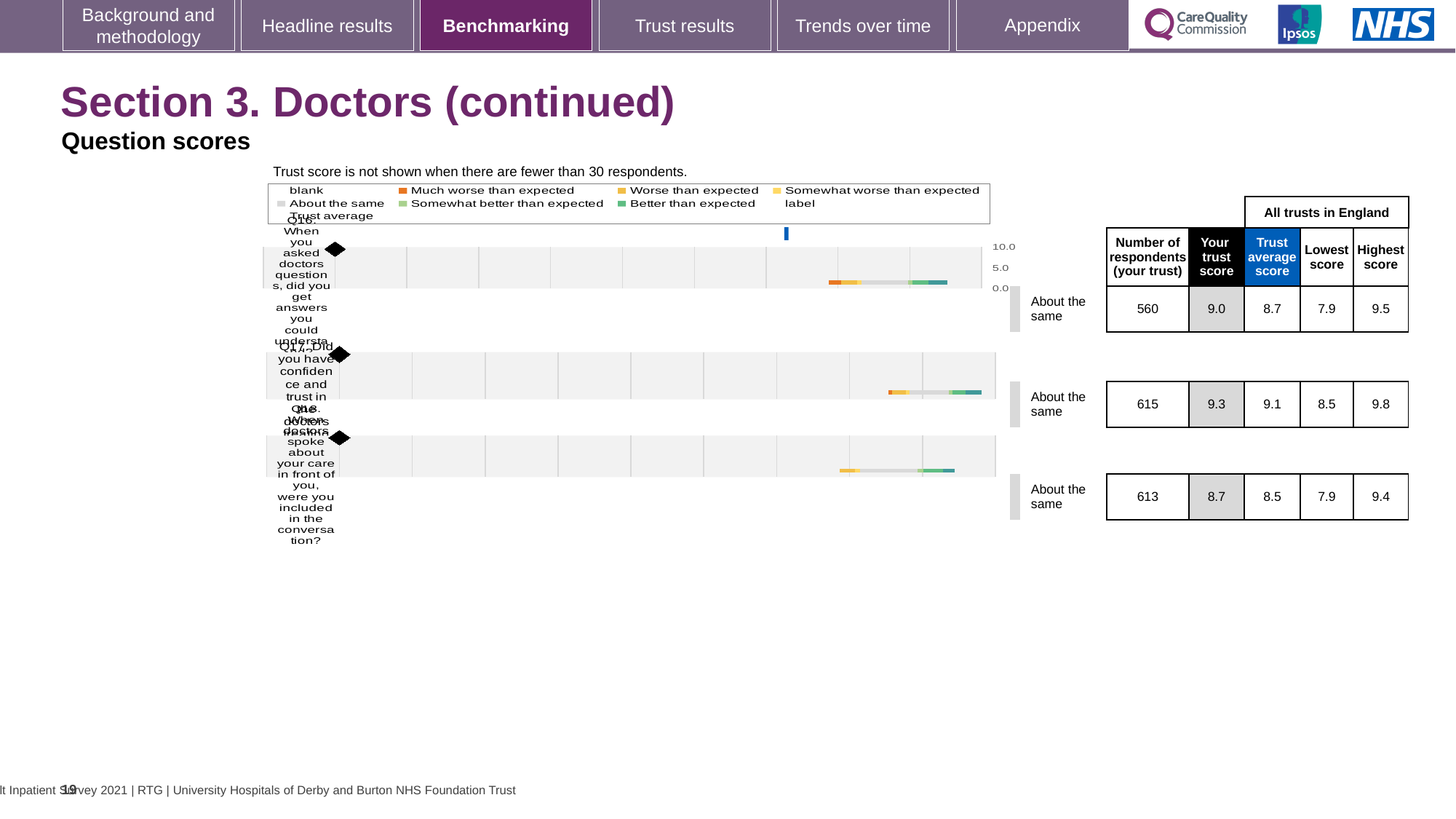
How many respondents (your trust) are shown for Q16? 560 Which question has the lowest 'Your trust score'? Q18 How many questions (Q16, Q17, Q18) are plotted on the slide? 3 For Q17, what is the difference between the 'Highest score' and the 'Lowest score'? 1.3 What benchmark category is shown next to the Q16 chart? About the same For Q16, which is larger: 'Your trust score' or the 'Trust average score'? Your trust score What is the maximum tick value shown on the chart axis? 10.0 Which question has the highest 'Your trust score'? Q17 What kind of chart is used to show the question scores on this slide? bar chart For Q17, what is the difference between 'Your trust score' and the 'Trust average score'? 0.2 What is the 'Your trust score' value for Q17? 9.3 What is the 'Highest score' across all trusts in England for Q18? 9.4